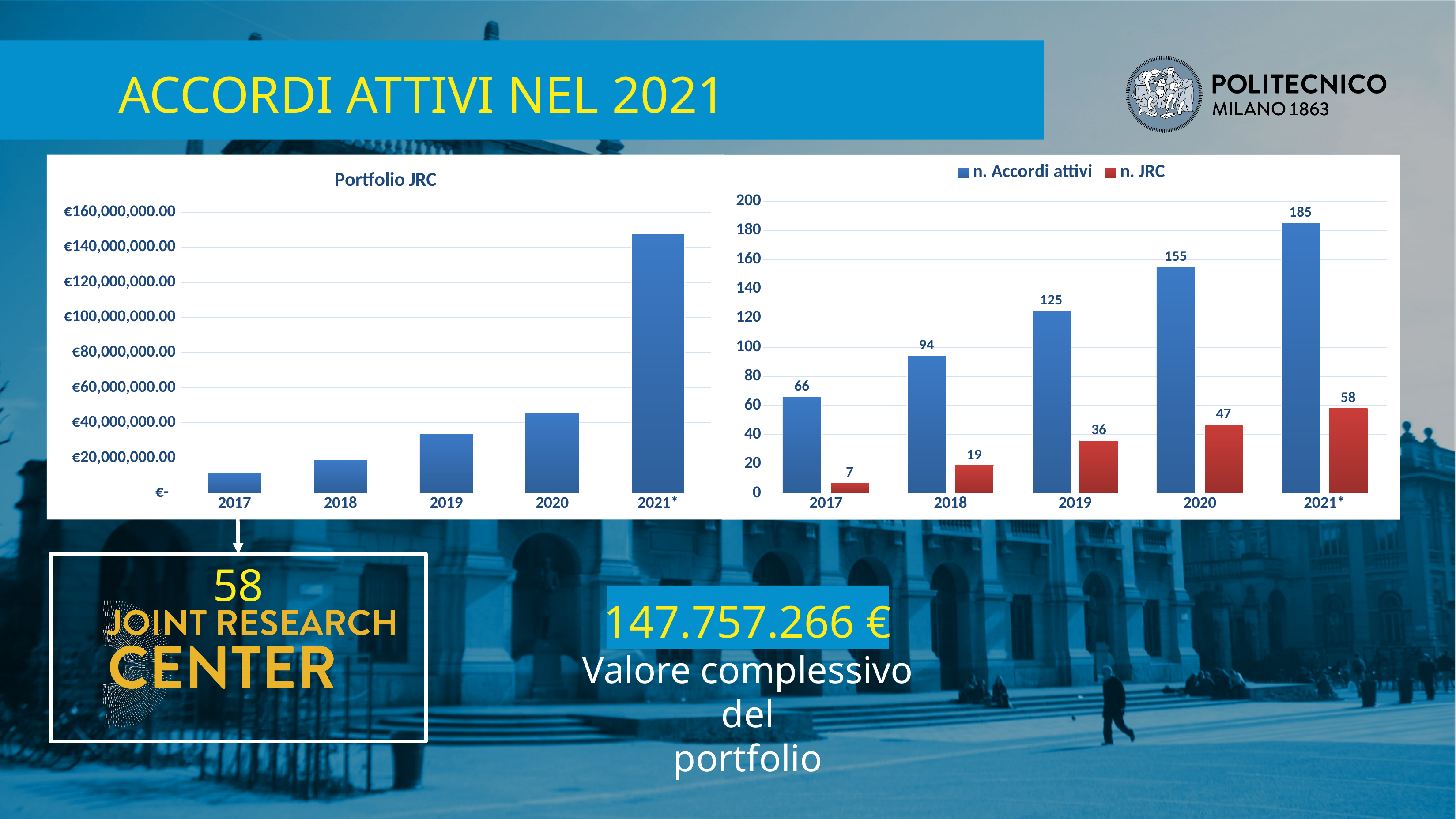
In the right-hand chart, what is the difference between n. Accordi attivi and n. JRC in 2020? 108 In the right-hand chart, do the n. JRC values rise or fall from 2017 to 2021*? rise In the right-hand chart, what is the value of n. Accordi attivi for 2021*? 185 What kind of chart is the Portfolio JRC chart? bar chart In the Portfolio JRC chart, is the value for 2019 greater or less than €40,000,000.00? less In the right-hand chart, what is the value of n. Accordi attivi for 2018? 94 In the right-hand chart, which year has the lowest value of n. JRC? 2017 In the Portfolio JRC chart, which year has the highest value? 2021* In the right-hand chart, which year has the highest value of n. Accordi attivi? 2021* In the Portfolio JRC chart, is the value for 2021* greater or less than €140,000,000.00? greater In the right-hand chart, what is the value of n. JRC for 2019? 36 In the right-hand chart, how many series does the legend list? 2